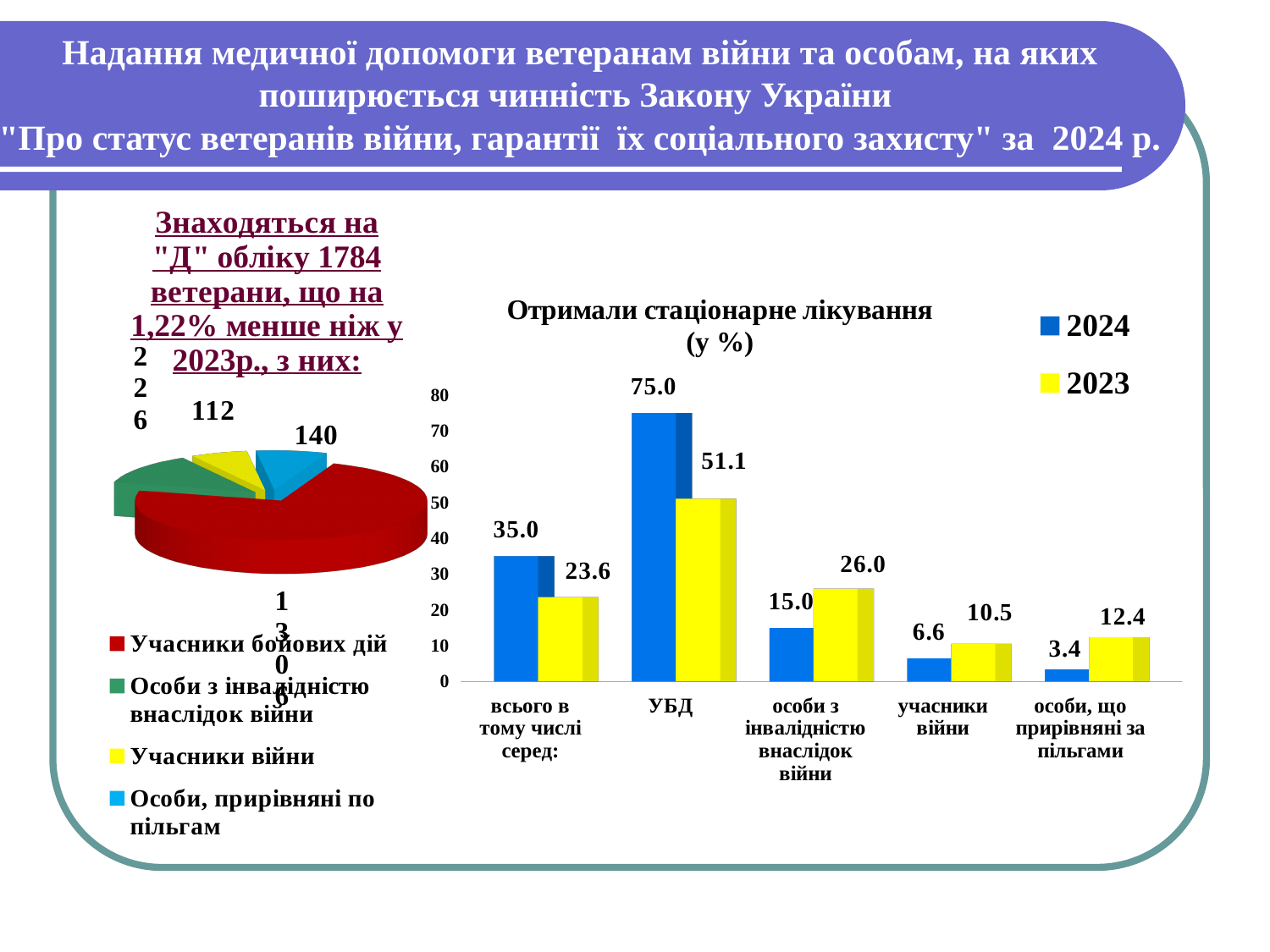
In the bar chart 'Отримали стаціонарне лікування (у %)', which category has the lowest 2023 value? учасники війни In the bar chart 'Отримали стаціонарне лікування (у %)', which is larger for 'особи з інвалідністю внаслідок війни': the 2024 value or the 2023 value? 2023 In the bar chart 'Отримали стаціонарне лікування (у %)', what is the 2024 value for 'особи, що прирівняні за пільгами'? 3.4 In the bar chart 'Отримали стаціонарне лікування (у %)', what is the 2023 value for 'всього в тому числі серед:'? 23.6 How many categories are shown on the x axis of the bar chart 'Отримали стаціонарне лікування (у %)'? 5 In the bar chart 'Отримали стаціонарне лікування (у %)', which category has the highest 2024 value? УБД How many series does the legend of the bar chart 'Отримали стаціонарне лікування (у %)' list? 2 In the bar chart 'Отримали стаціонарне лікування (у %)', what is the 2024 value for УБД? 75.0 What kind of chart is the chart on the left of the slide? Pie chart In the bar chart 'Отримали стаціонарне лікування (у %)', what is the difference between the 2024 and 2023 values for УБД? 23.9 In the pie chart on the left, what is the value for 'Особи, прирівняні по пільгам'? 140 In the pie chart on the left, which category has the largest slice? Учасники бойових дій